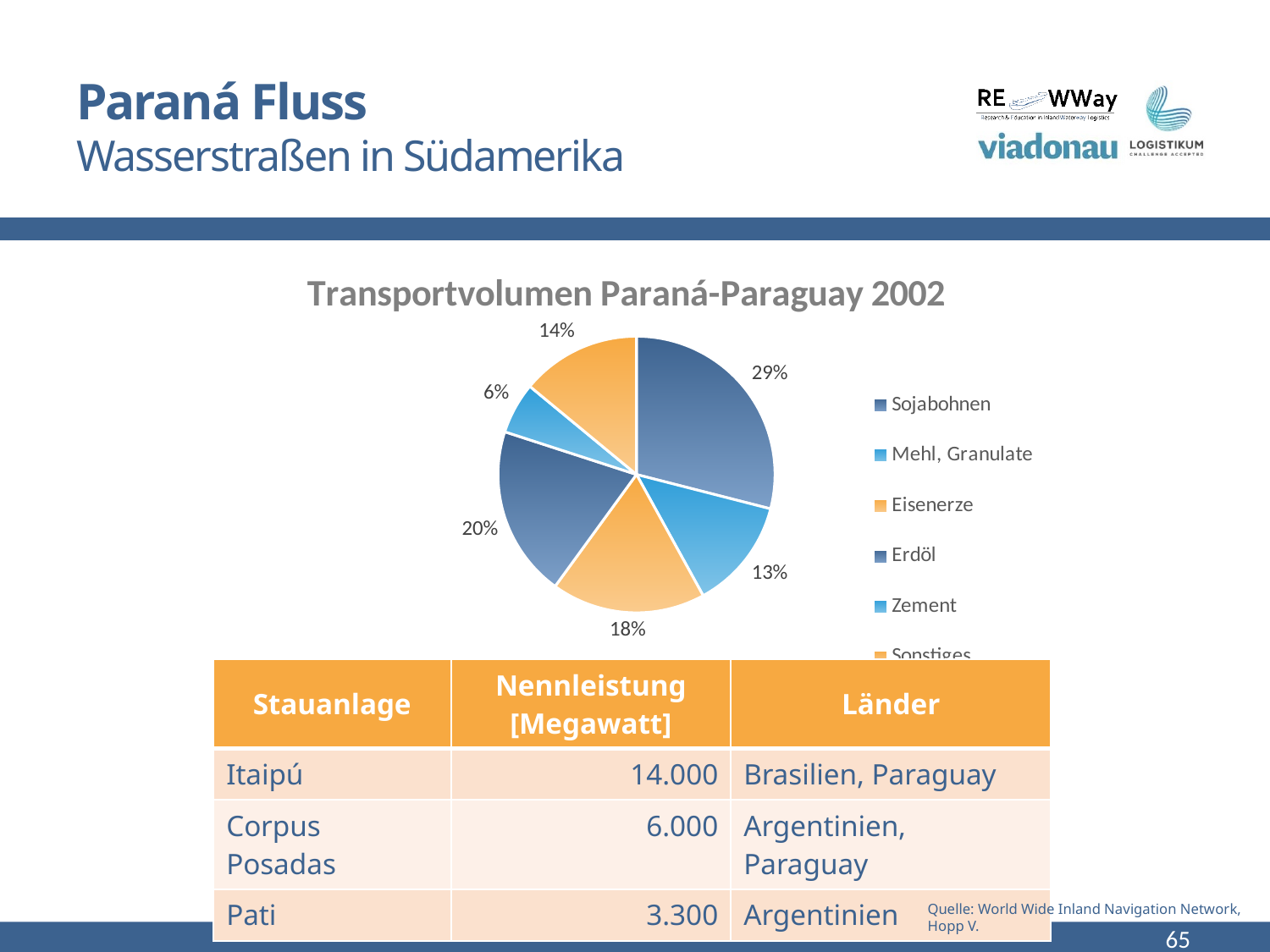
How many percentage points larger is the Sojabohnen share than the Erdöl share? 9 What share of the transport volume is Sojabohnen? 29% Which has a larger share, Eisenerze or Mehl, Granulate? Eisenerze How many slices does the pie chart have? 6 What share of the transport volume is Mehl, Granulate? 13% What share of the transport volume is Eisenerze? 18% Which category has the smallest share of the pie? Zement What kind of chart is shown on the slide? Pie chart What share of the transport volume is Zement? 6% What share of the transport volume is Erdöl? 20% What is the title of the chart? Transportvolumen Paraná-Paraguay 2002 Which category has the largest share of the pie? Sojabohnen